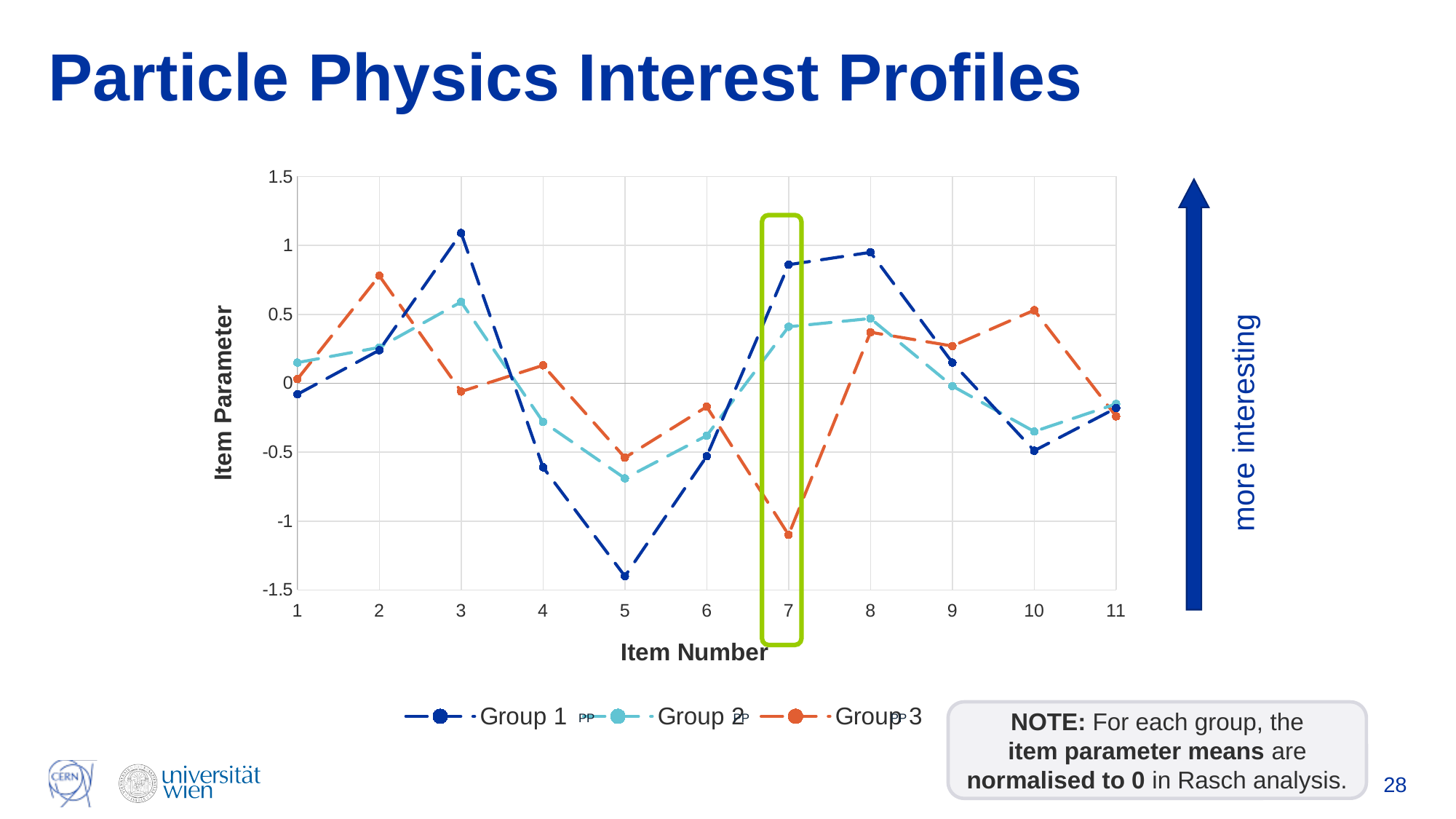
At item 7, which group has the larger item parameter, Group 1 or Group 3? Group 1 At item 2, which group has the larger item parameter, Group 1 or Group 3? Group 3 Is the item parameter for Group 1 at item 5 greater or less than -1? less How many item numbers are plotted along the x axis? 11 How many series does the legend list? 3 What is the label of the y axis? Item Parameter At which item number does Group 3 reach its lowest item parameter? 7 What type of chart is shown on the slide? line chart At which item number does Group 3 reach its highest item parameter? 2 At which item number does Group 1 reach its highest item parameter? 3 Is the item parameter for Group 3 at item 7 greater or less than -1? less At which item number does Group 1 reach its lowest item parameter? 5